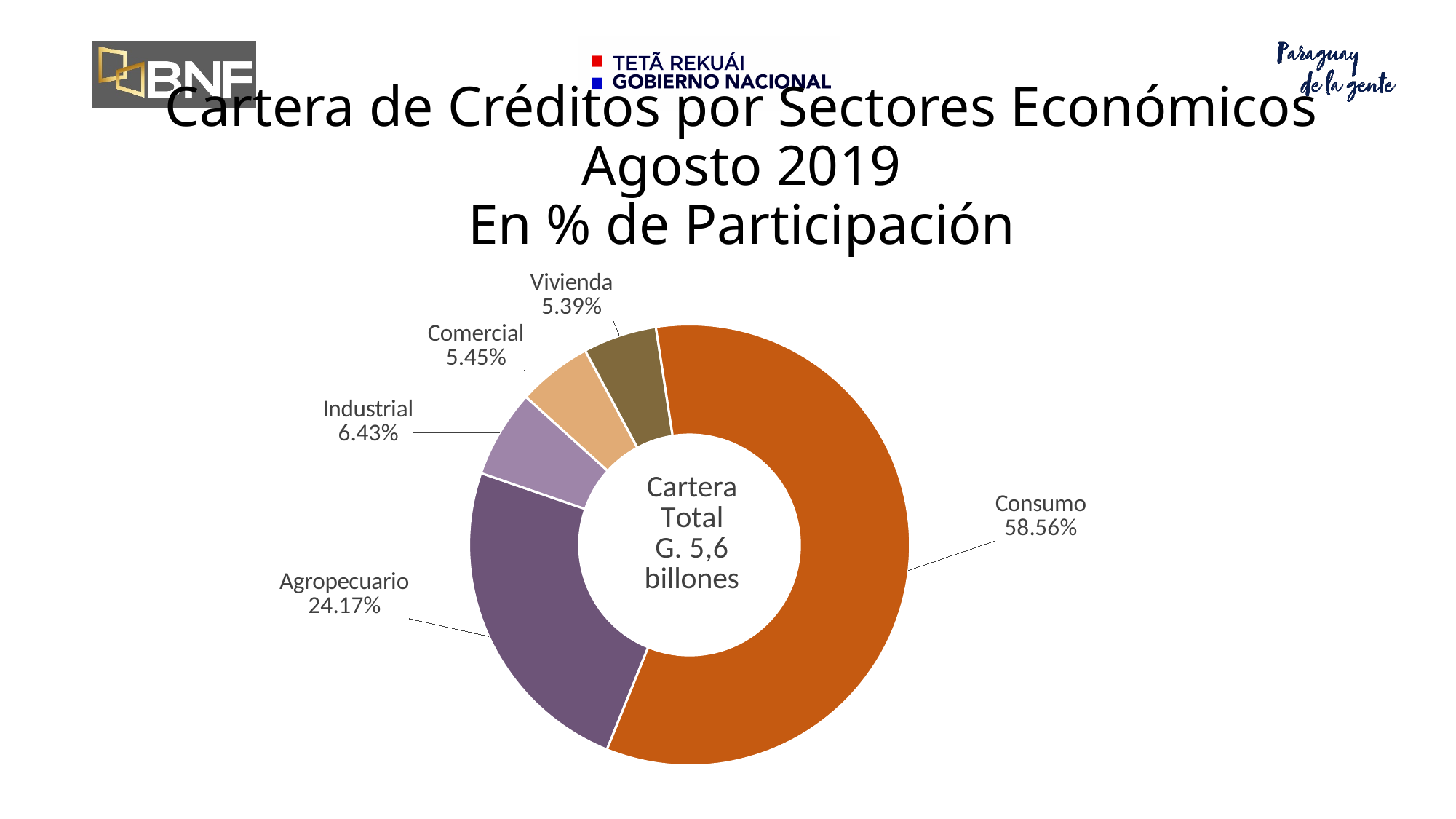
What is the share of the Industrial sector? 6.43% What percentage is shown for the Agropecuario sector? 24.17% What kind of chart is shown on the slide? Doughnut (pie) chart What is the difference in percentage points between Consumo and Agropecuario? 34.39 Which has a larger share, Industrial or Comercial? Industrial What share of the credit portfolio does the Consumo sector hold? 58.56% Which sector has the largest share of the portfolio? Consumo How many sectors are shown in the chart? 5 Which sector has the smallest share of the portfolio? Vivienda What percentage is labelled for Vivienda? 5.39% What colour is the Consumo slice? Orange What total portfolio value is written in the centre of the chart? G. 5,6 billones